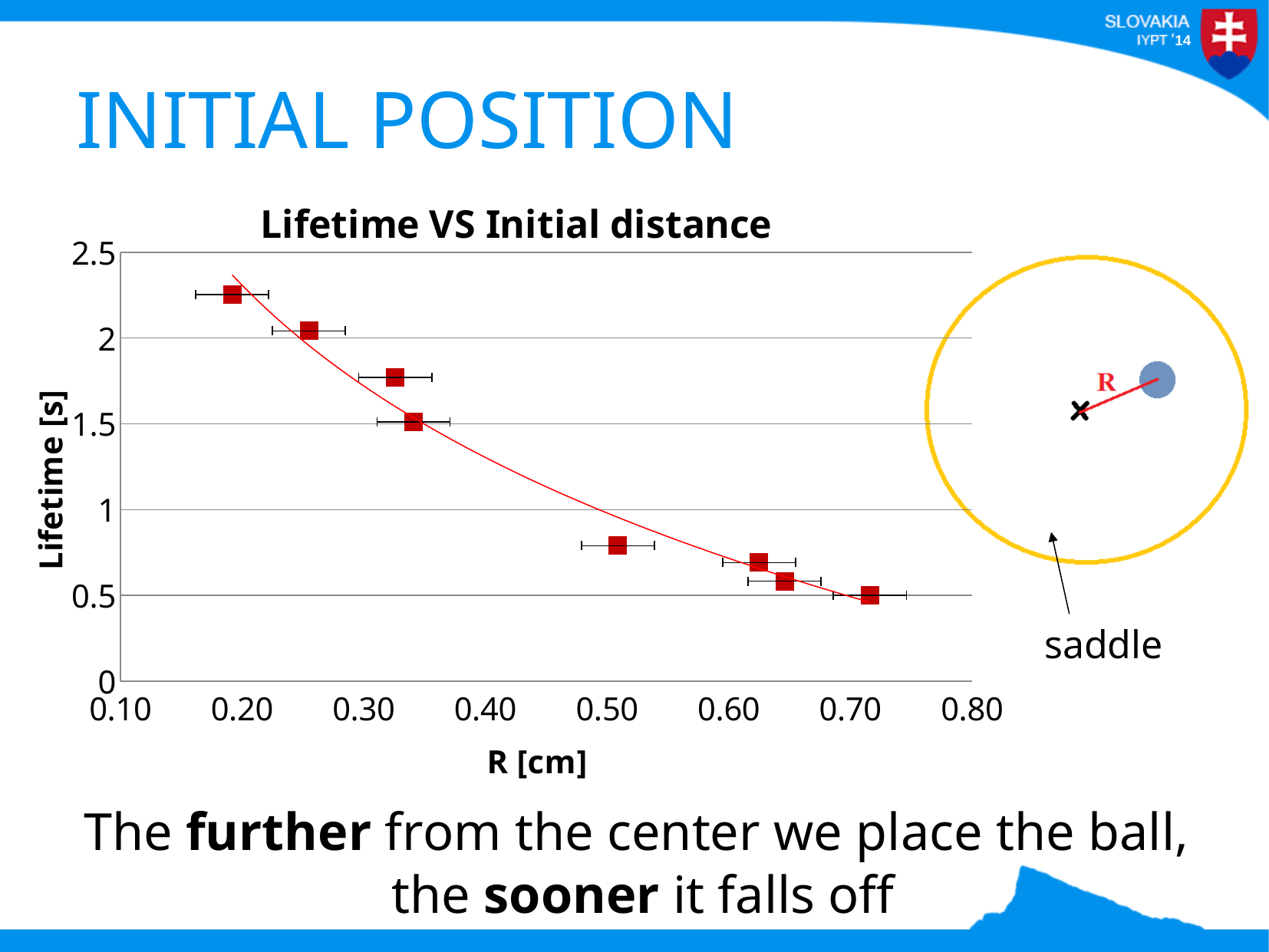
Is the lifetime of the data point with the smallest R (near 0.20 cm) greater or less than 2? greater How many data points are plotted in the chart? 8 Is the lifetime of the data point near R = 0.50 cm greater or less than 1? less What kind of chart is shown on the slide? scatter chart Does the lifetime rise or fall as R increases along the x axis? fall What is the highest value shown on the y axis? 2.5 What is the label of the y axis? Lifetime [s] Which has the longer lifetime: the data point near R = 0.20 cm or the data point near R = 0.70 cm? the data point near R = 0.20 cm What is the title of the chart? Lifetime VS Initial distance Is the lifetime of the data point with the largest R (near 0.70 cm) greater or less than 1? less